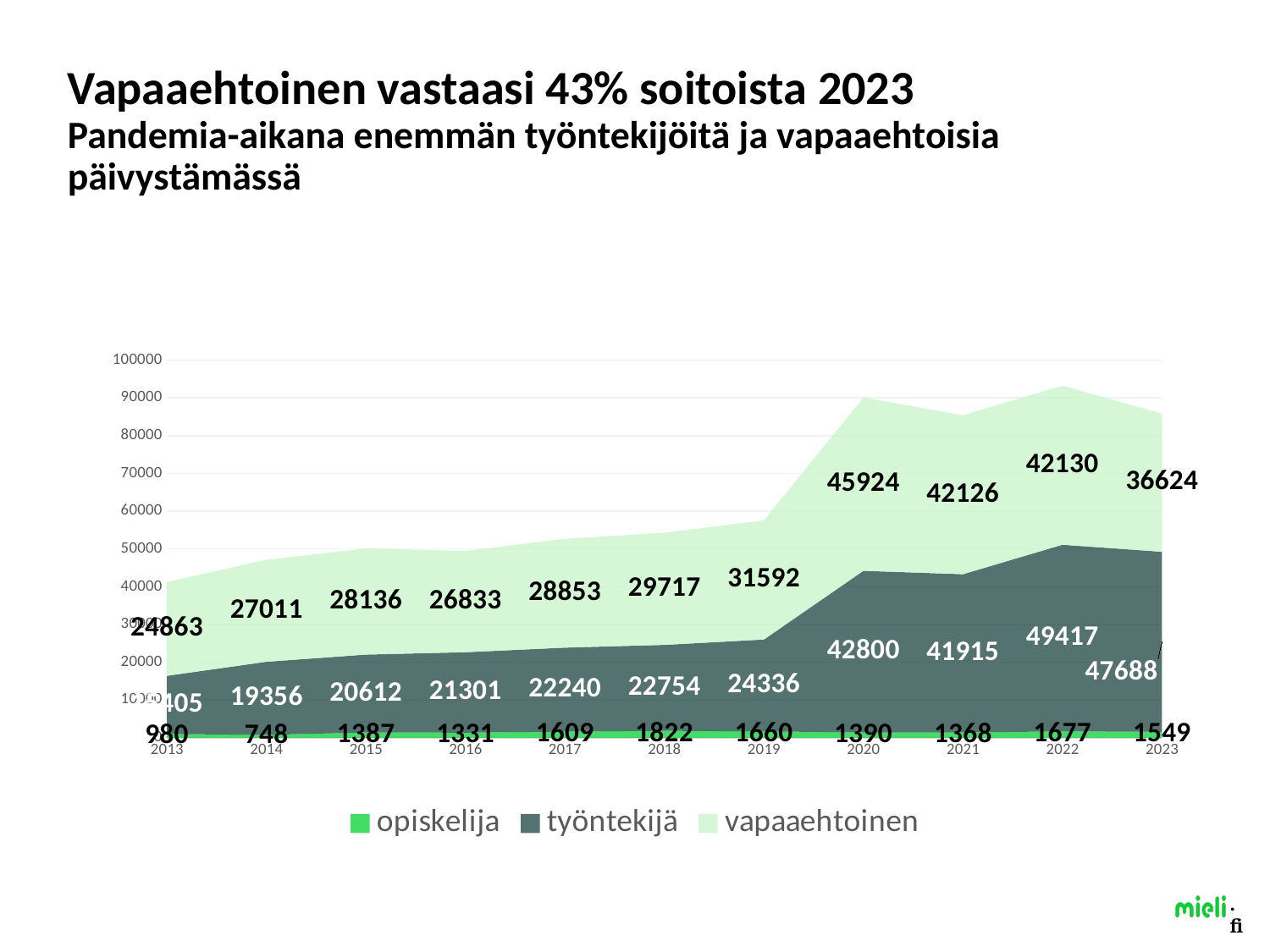
What is the value for vapaaehtoinen in 2020? 45924 Which year has the larger työntekijä value, 2020 or 2021? 2020 What is the value for opiskelija in 2018? 1822 What kind of chart is shown on the slide? Stacked area chart What is the value for työntekijä in 2022? 49417 What is the total of the three series for 2023? 85861 How many years are shown on the x axis? 11 How many series does the legend list? 3 In which year is the työntekijä value highest? 2022 In which year is the opiskelija value lowest? 2014 What is the difference between the vapaaehtoinen values for 2022 and 2023? 5506 In which year is the opiskelija value highest? 2018